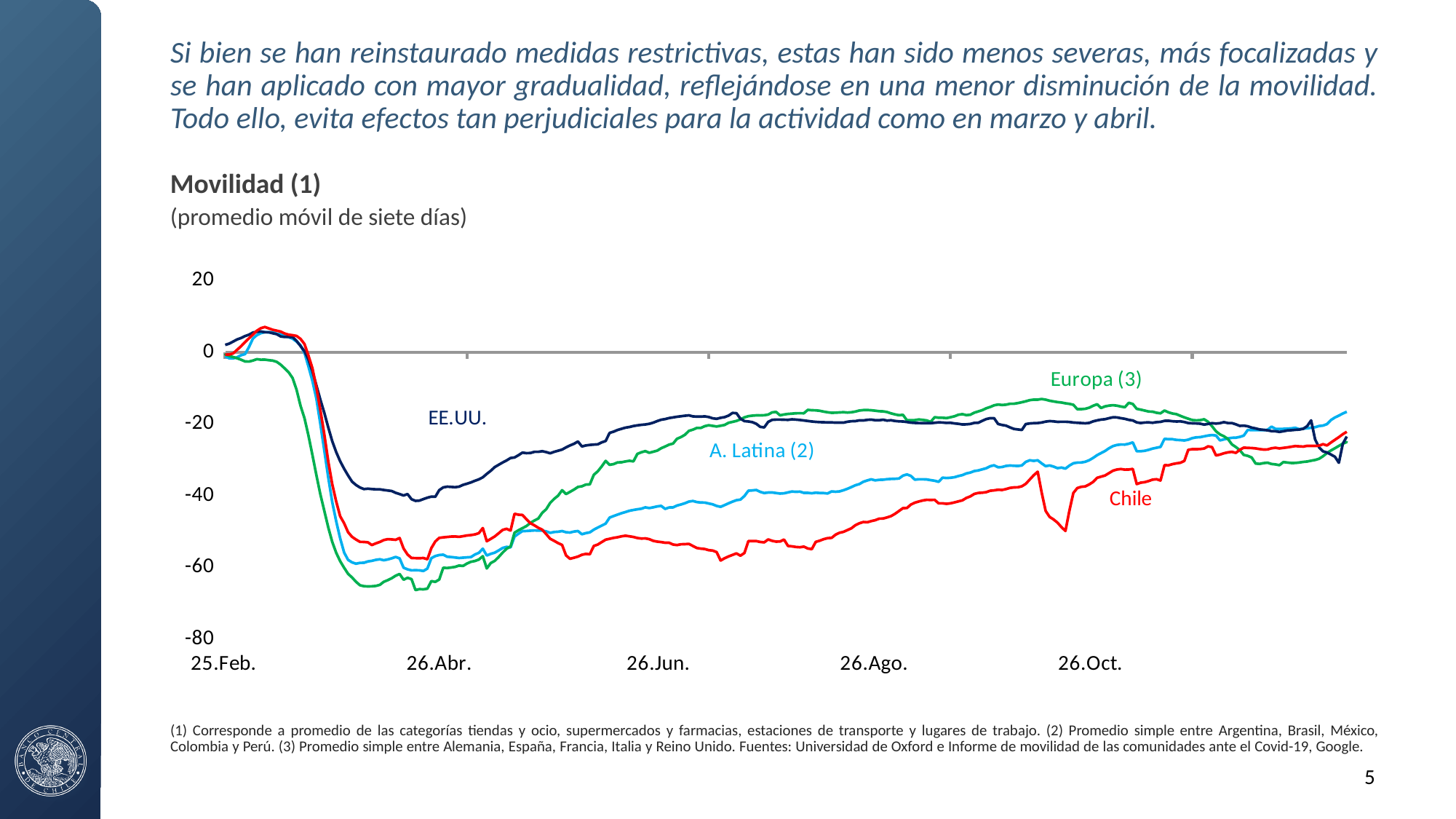
What is the title of the chart? Movilidad (1) How many series are plotted in the chart? 4 Which series has the highest value at 26.Ago.? Europa (3) Is the value for A. Latina (2) at 26.Abr. greater or less than -40? less Which series has the lowest value at 26.Oct.? Chile Which series is plotted in red? Chile What kind of chart is shown on the slide? line chart Is the value for Chile at 26.Jun. greater or less than -40? less Is the value for EE.UU. at 26.Jun. greater or less than -20? greater How many date labels are shown on the x axis? 5 Which series reaches the lowest point in the chart? Europa (3) Between 26.Abr. and 26.Oct., does the Chile series generally rise or fall? rise